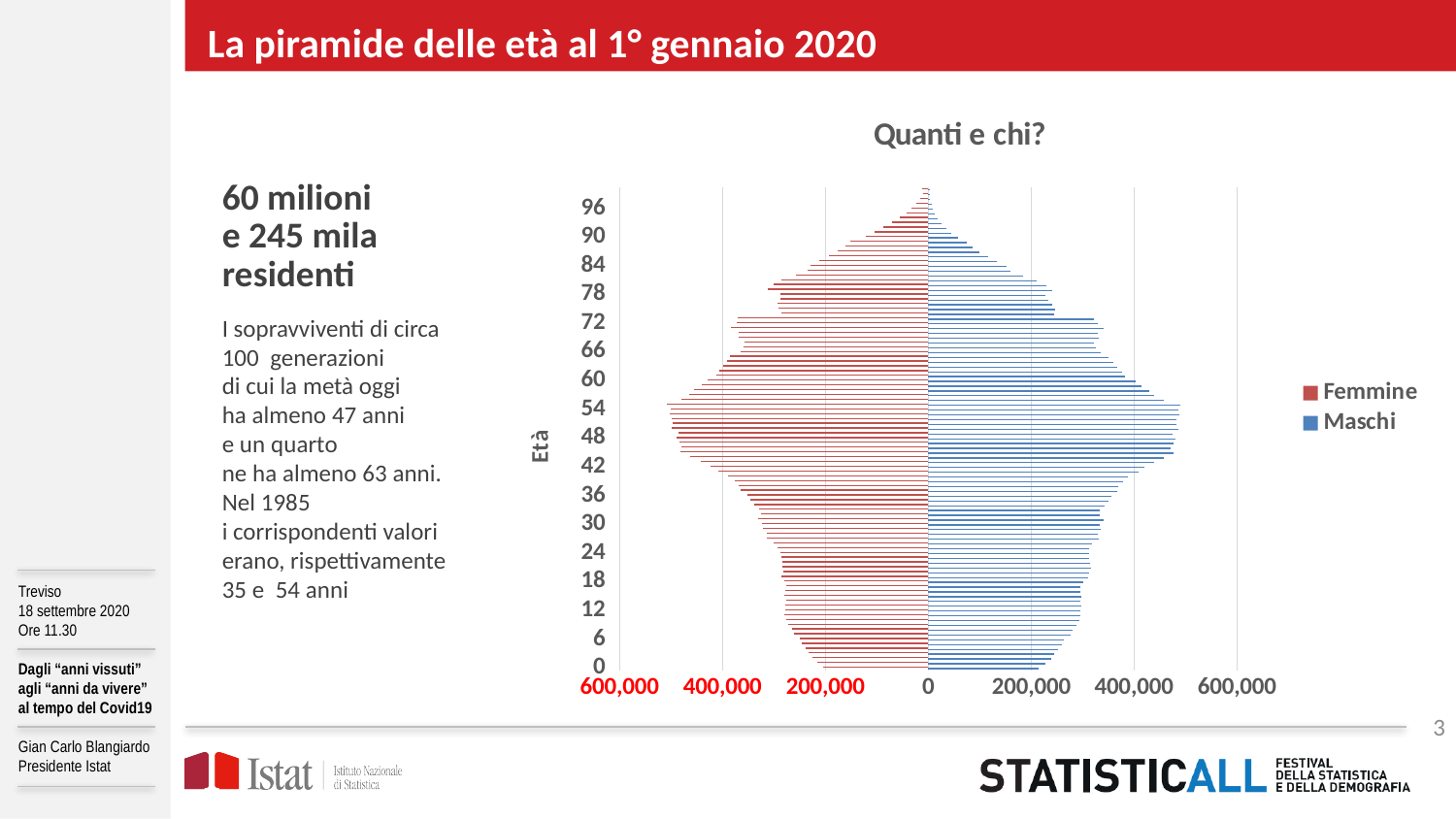
How many series does the chart legend list? 2 Moving up the vertical axis from age 54 to age 96, do the bar lengths rise or fall? fall Is the Femmine value at age 54 greater or less than 400,000? greater What kind of chart is shown on the slide? bar chart Is the Maschi value at age 54 greater or less than 400,000? greater Is the Femmine value at age 90 greater or less than 200,000? less What is the title of the vertical axis of the chart? Età What are the two series named in the chart legend? Femmine and Maschi At age 84, which series has the larger value, Femmine or Maschi? Femmine